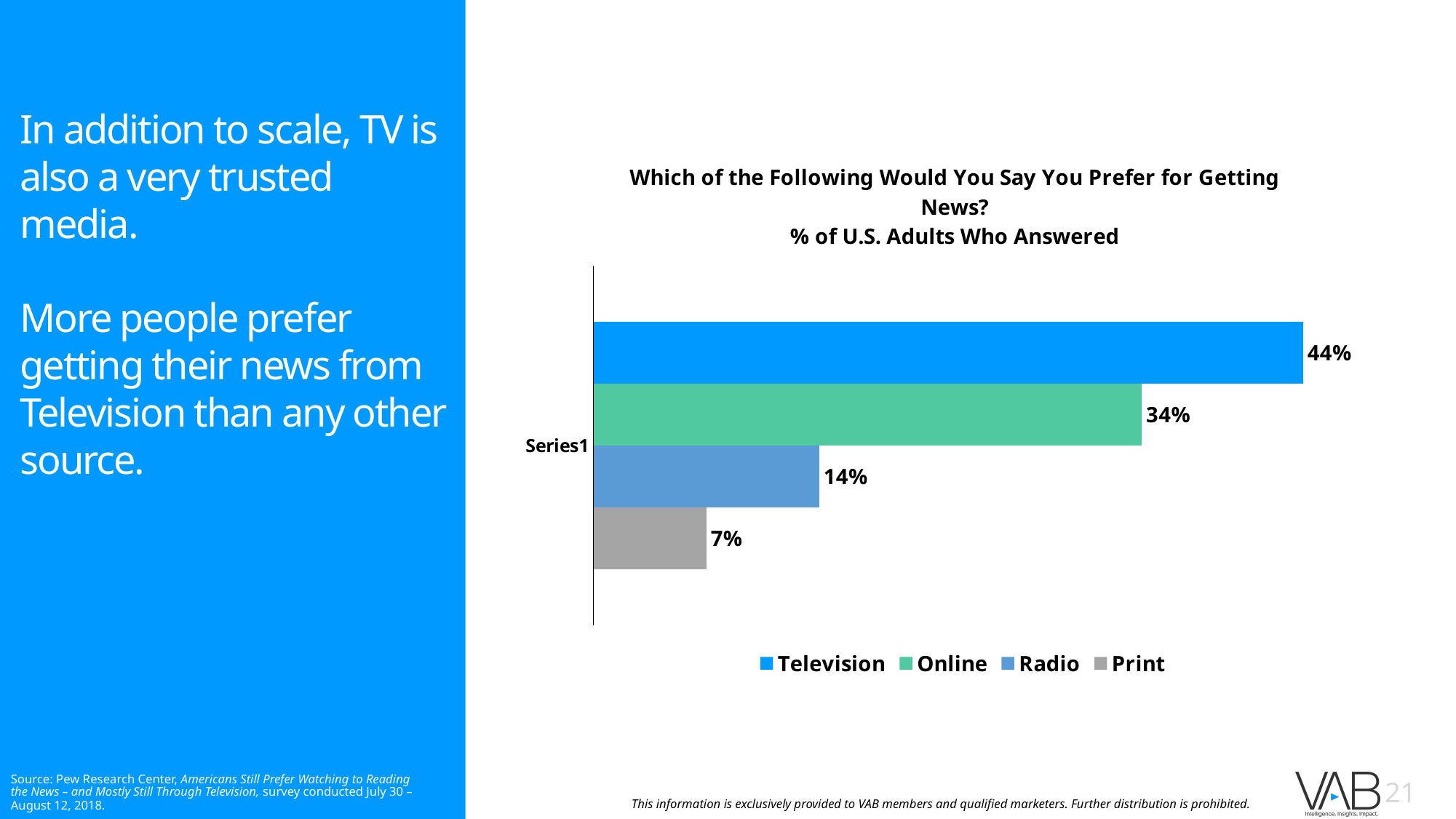
What percentage of U.S. adults said they prefer Print for getting news? 7% Which is larger, the value for Online or the value for Radio? Online Which news source has the highest share of U.S. adults preferring it? Television Which news source has the lowest share of U.S. adults preferring it? Print What is the difference in percentage points between Television and Online? 10 How many series does the legend list? 4 What is the difference in percentage points between Radio and Print? 7 What colour is the bar for Online in the chart? Green What percentage of U.S. adults said they prefer Television for getting news? 44% What percentage of U.S. adults said they prefer Online for getting news? 34% What percentage of U.S. adults said they prefer Radio for getting news? 14% What kind of chart is shown on the slide? Bar chart